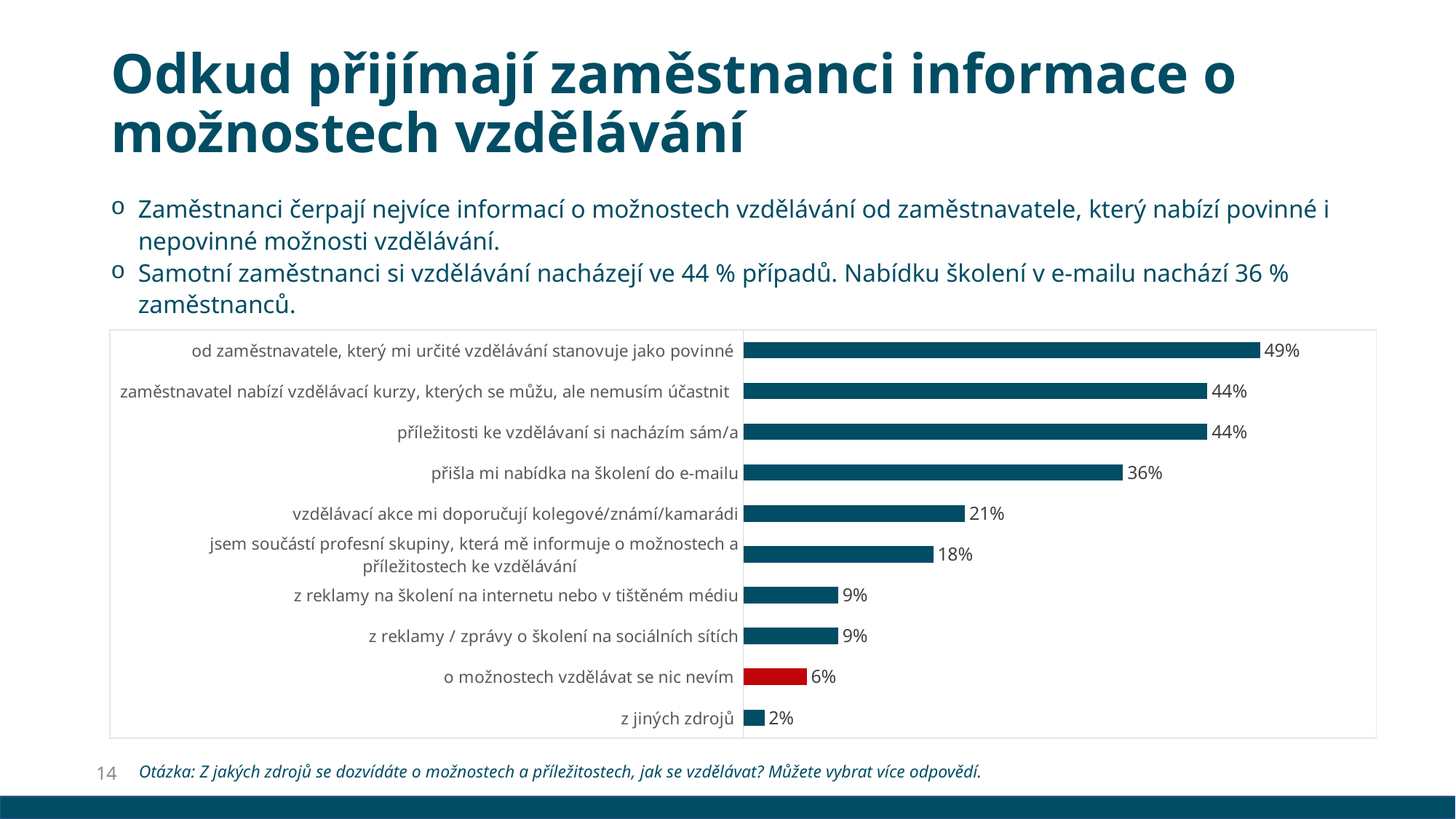
Which is larger: the value for "vzdělávací akce mi doporučují kolegové/známí/kamarádi" or the value for "jsem součástí profesní skupiny, která mě informuje o možnostech a příležitostech ke vzdělávání"? vzdělávací akce mi doporučují kolegové/známí/kamarádi What type of chart is shown on the slide? bar chart What is the value for "vzdělávací akce mi doporučují kolegové/známí/kamarádi"? 21% What is the difference between the value for "o možnostech vzdělávat se nic nevím" and the value for "z jiných zdrojů"? 4% Which category has the highest value? od zaměstnavatele, který mi určité vzdělávání stanovuje jako povinné What is the value for "o možnostech vzdělávat se nic nevím"? 6% What is the value for "jsem součástí profesní skupiny, která mě informuje o možnostech a příležitostech ke vzdělávání"? 18% What is the difference between the value for "od zaměstnavatele, který mi určité vzdělávání stanovuje jako povinné" and the value for "přišla mi nabídka na školení do e-mailu"? 13% Which category's bar is coloured red instead of dark blue? o možnostech vzdělávat se nic nevím Which category has the lowest value? z jiných zdrojů What is the value for "přišla mi nabídka na školení do e-mailu"? 36% How many categories does the chart show? 10